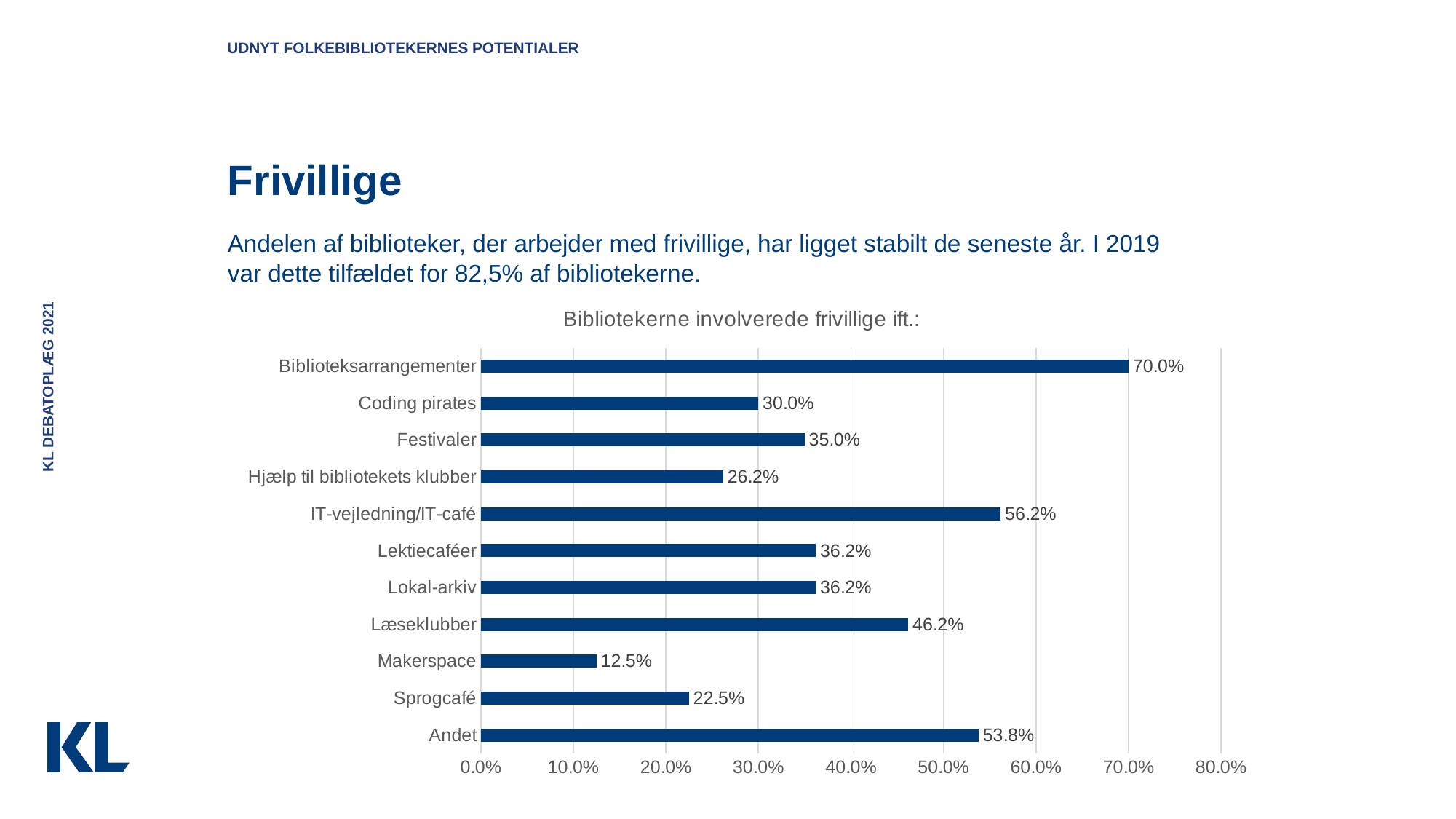
What is the difference between the values for Coding pirates and Makerspace? 17.5% Which category has the highest value? Biblioteksarrangementer How many categories are shown in the chart? 11 Which is larger, the value for Læseklubber or the value for Festivaler? Læseklubber What is the difference between the values for Biblioteksarrangementer and Andet? 16.2% What is the value for Sprogcafé? 22.5% What is the value for Biblioteksarrangementer? 70.0% What is the title of the chart? Bibliotekerne involverede frivillige ift.: What is the value for IT-vejledning/IT-café? 56.2% Is the value for Hjælp til bibliotekets klubber greater or less than 30.0%? less What kind of chart is shown on the slide? bar chart Which category has the lowest value? Makerspace